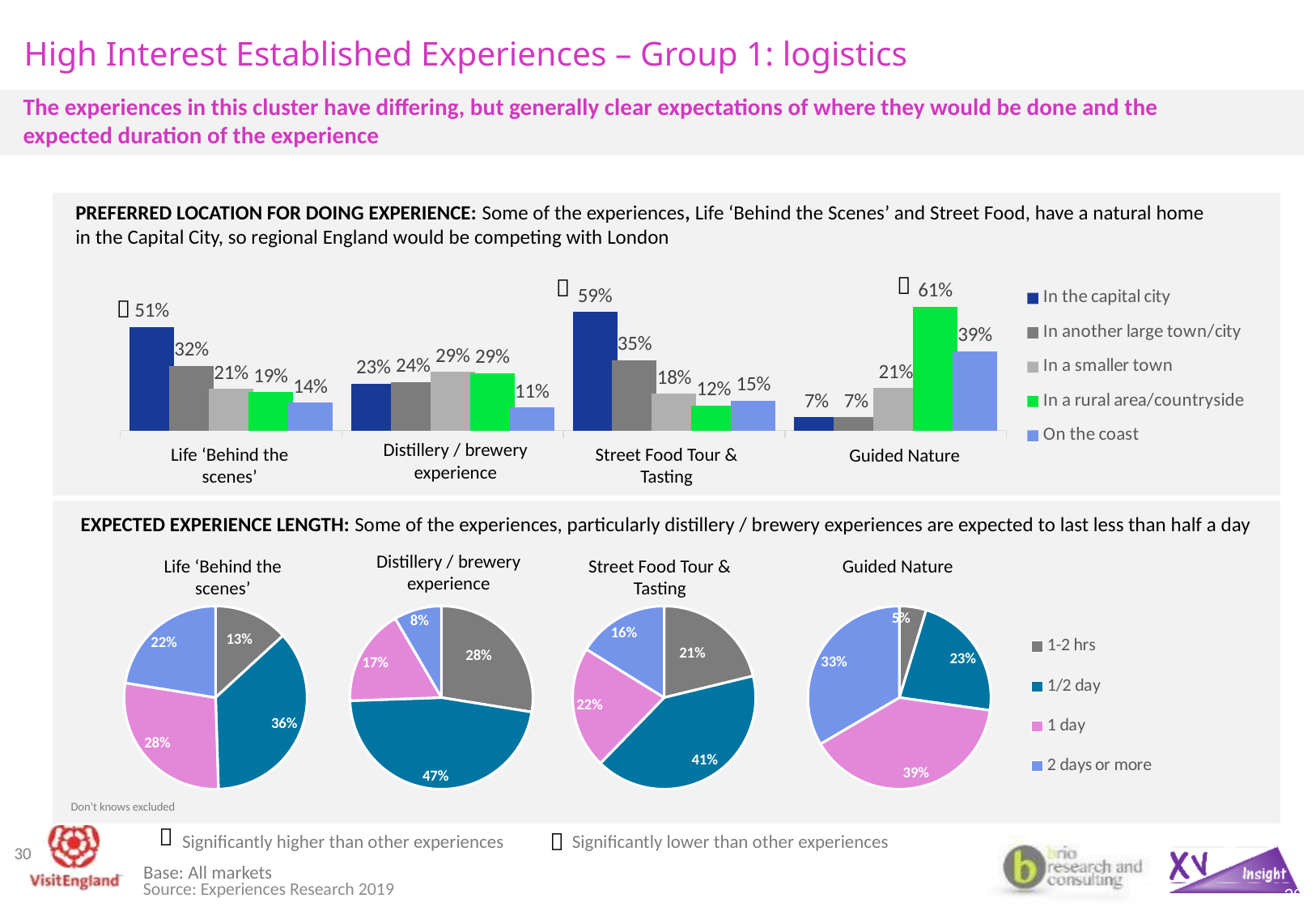
In the 'Expected experience length' pie chart for Street Food Tour & Tasting, what share is '1-2 hrs'? 21% In the 'Preferred location for doing experience' bar chart, how many series does the legend list? 5 How many pie charts are shown in the 'Expected experience length' section? 4 In the 'Preferred location for doing experience' bar chart, which location has the highest value for Life 'Behind the scenes'? In the capital city What kind of chart is used for 'Preferred location for doing experience'? Bar chart In the 'Preferred location for doing experience' bar chart, what percentage of respondents chose 'In the capital city' for Street Food Tour & Tasting? 59% In the 'Expected experience length' pie chart for Distillery / brewery experience, what share is '1/2 day'? 47% In the 'Expected experience length' pie chart for Guided Nature, which duration has the largest share? 1 day In the 'Preferred location for doing experience' bar chart, which location has the lowest value for Distillery / brewery experience? On the coast In the 'Preferred location for doing experience' bar chart, what is the difference between 'In the capital city' and 'In another large town/city' for Life 'Behind the scenes'? 19 percentage points In the 'Expected experience length' pie chart for Life 'Behind the scenes', which is larger: '1 day' or '2 days or more'? 1 day In the 'Preferred location for doing experience' bar chart, what is the value for 'In a rural area/countryside' for Guided Nature? 61%